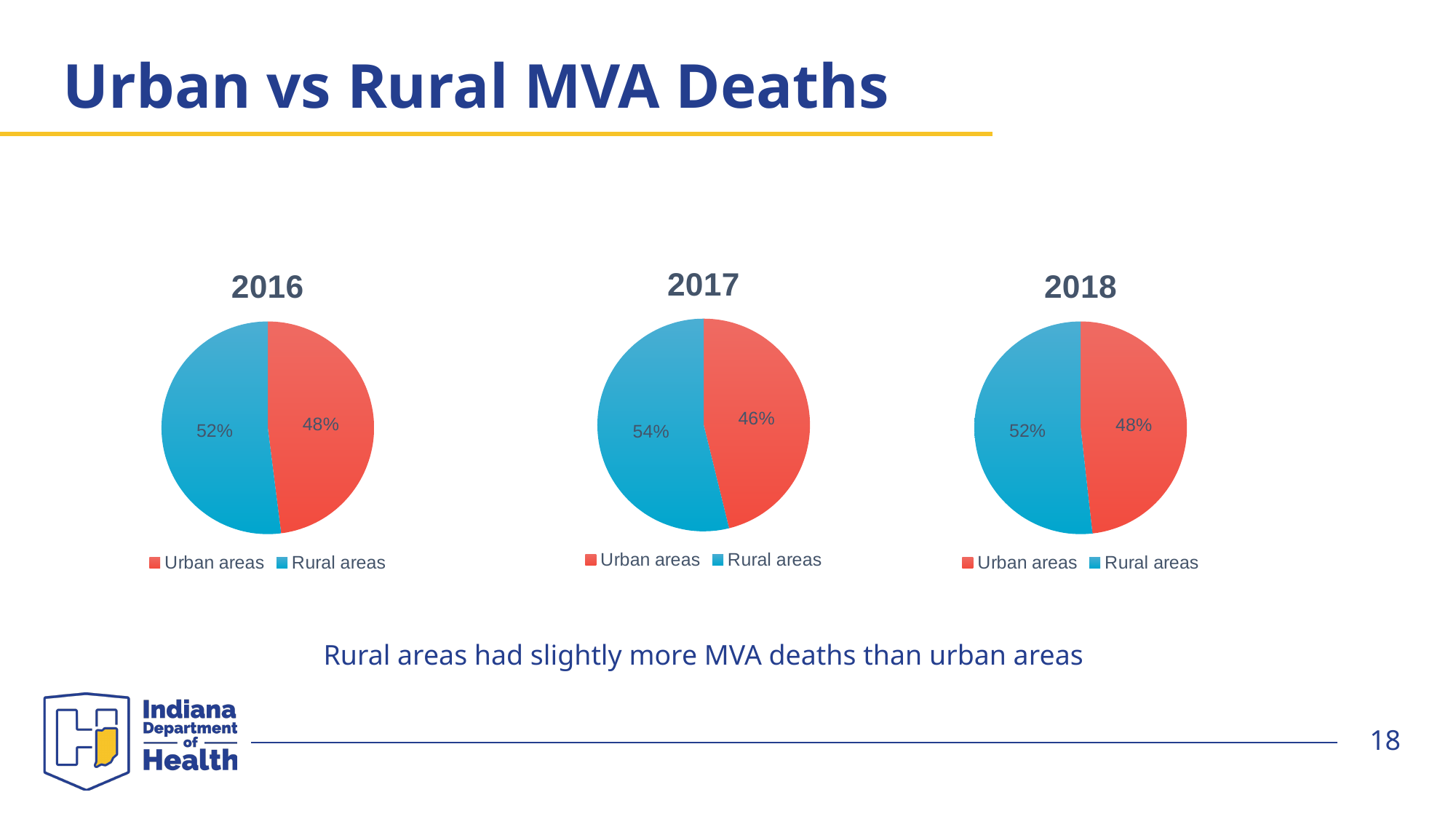
How many series does the legend of the 2018 pie chart list? 2 In the 2016 pie chart, what share of MVA deaths is for Rural areas? 52% In the 2016 pie chart, what share of MVA deaths is for Urban areas? 48% In the 2017 pie chart, what share of MVA deaths is for Rural areas? 54% In the 2017 pie chart, what share of MVA deaths is for Urban areas? 46% In the 2017 pie chart, what is the difference in percentage points between Rural areas and Urban areas? 8 In the 2018 pie chart, what share of MVA deaths is for Rural areas? 52% In the 2017 pie chart, which slice is larger, Urban areas or Rural areas? Rural areas What kind of chart is used for the 2018 data? Pie chart How many slices does the 2016 pie chart have? 2 In the 2016 pie chart, what is the difference in percentage points between Rural areas and Urban areas? 4 In the 2016 pie chart, which colour represents Rural areas? Blue